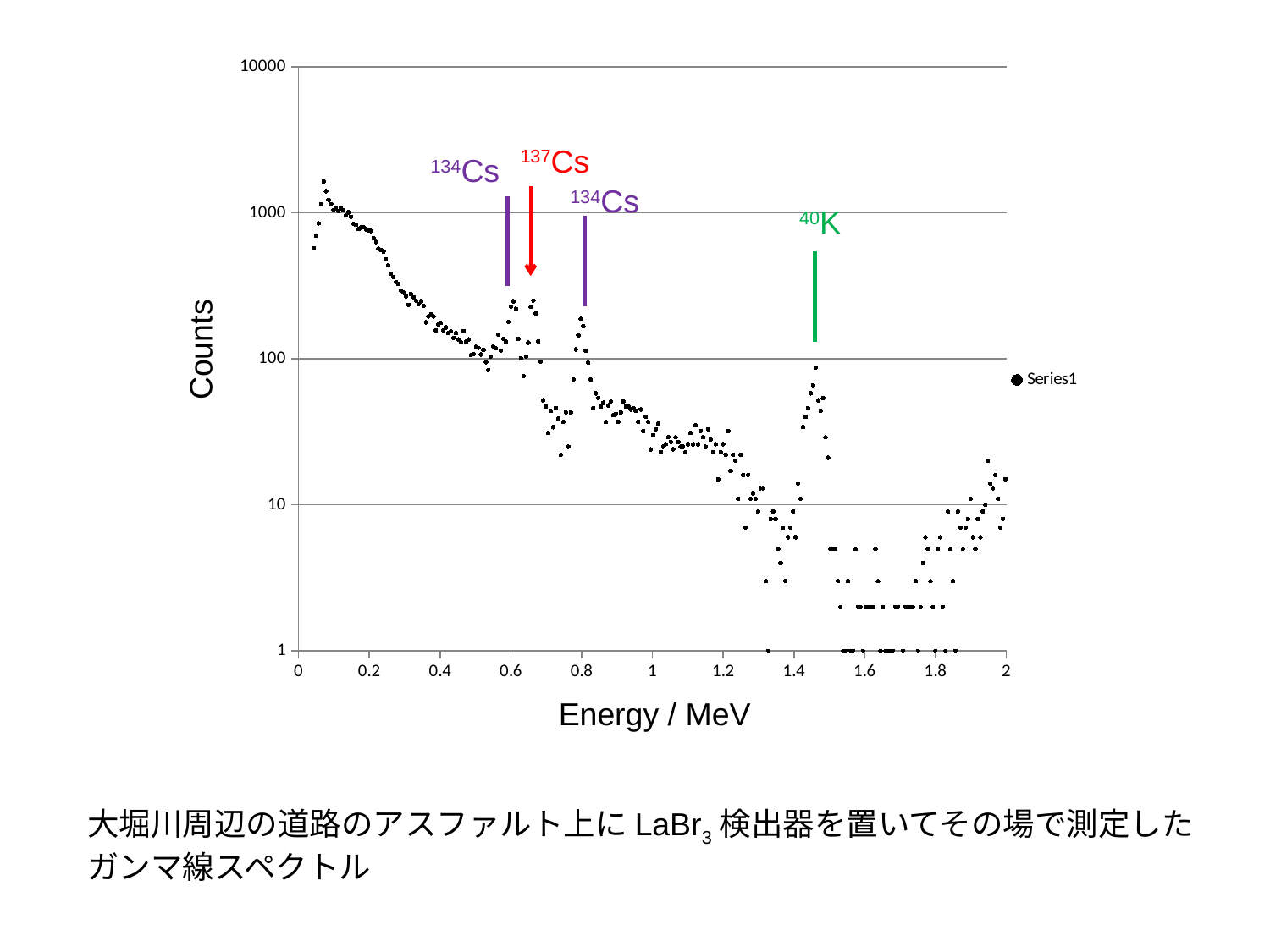
Which is larger, the value at 0.2 MeV or the value at 1.2 MeV? 0.2 MeV Is the value at 1.6 MeV greater or less than 10? less Is the value at 1.0 MeV greater or less than 10? greater What kind of chart is shown on the slide? scatter chart Is the value at 1.0 MeV greater or less than 100? less What is the title of the x axis? Energy / MeV How many series does the legend list? 1 Overall, do the counts rise or fall as energy increases from 0.2 MeV to 1.6 MeV? fall What is the name of the series shown in the legend? Series1